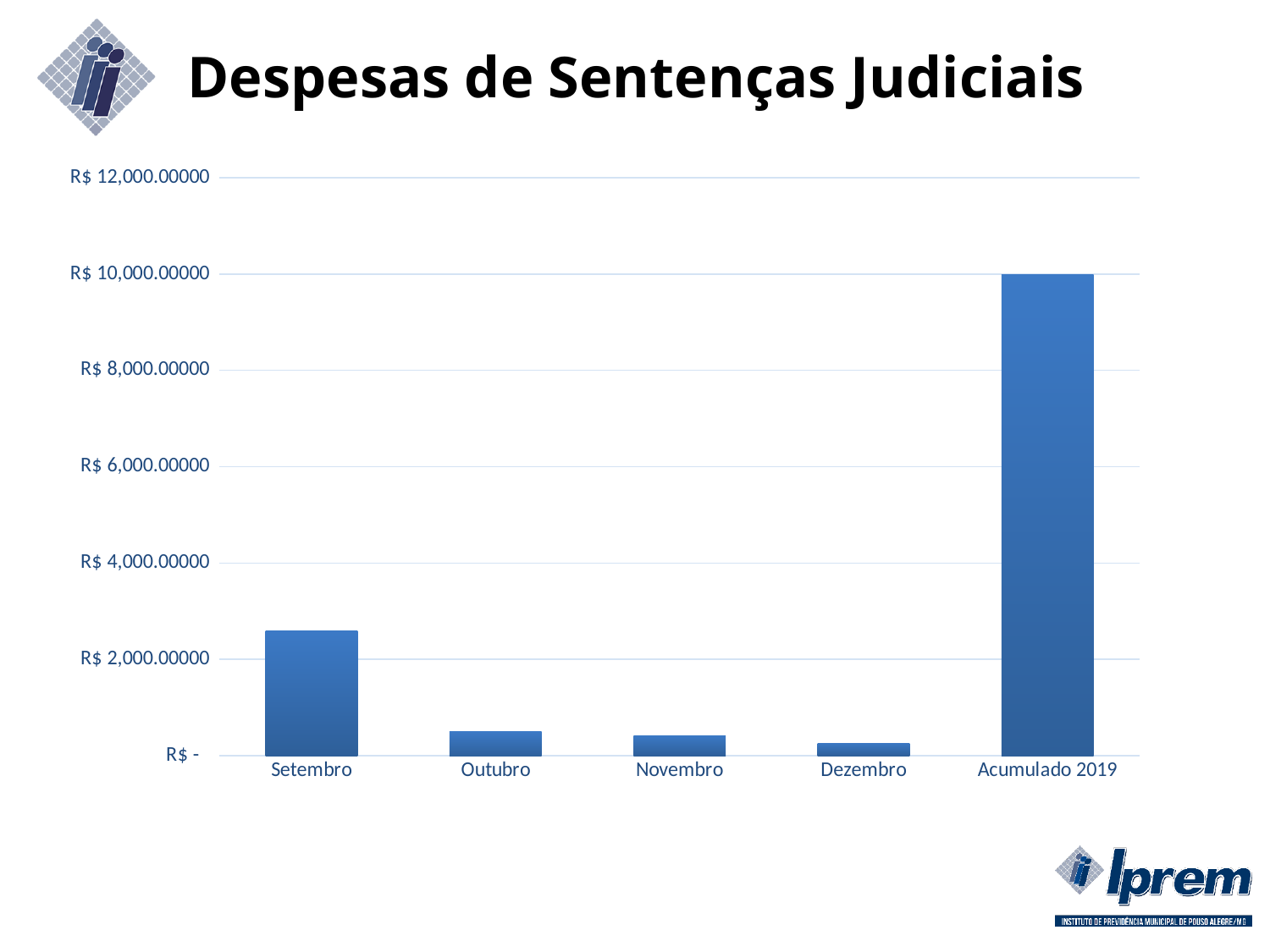
What is the title of the chart on the slide? Despesas de Sentenças Judiciais Do the monthly values rise or fall from Setembro to Dezembro? fall Which has a larger value, Setembro or Outubro? Setembro Is the value for Acumulado 2019 greater or less than R$ 8,000.00000? greater Which has a larger value, Novembro or Dezembro? Novembro Is the value for Outubro greater or less than R$ 2,000.00000? less Which category has the highest value in the chart? Acumulado 2019 Which category has the lowest value in the chart? Dezembro What is the highest tick label shown on the y axis? R$ 12,000.00000 Is the value for Setembro greater or less than R$ 2,000.00000? greater What kind of chart is shown on the slide? bar chart How many categories are shown on the x axis of the chart? 5